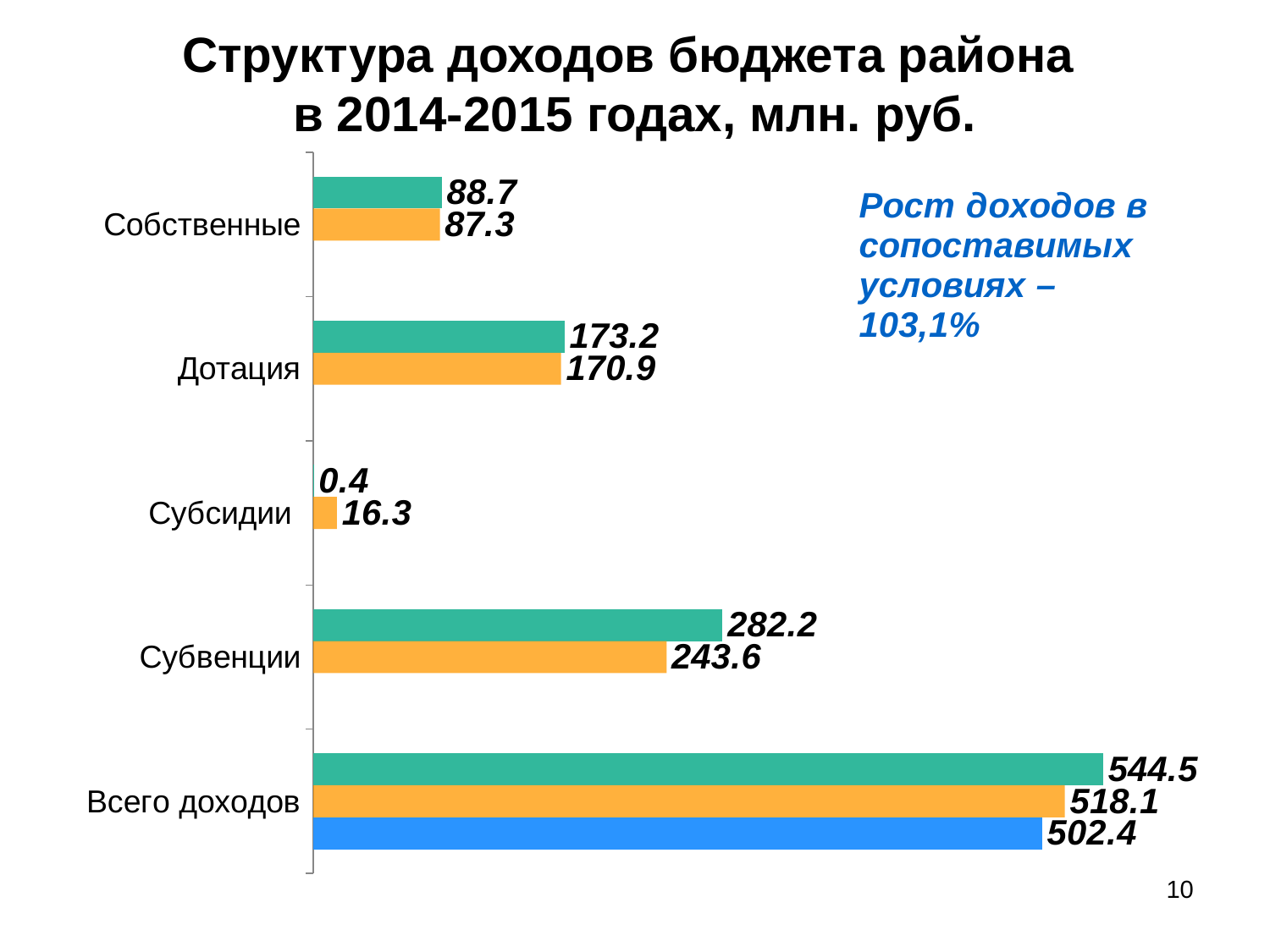
What is the value of the blue bar for Всего доходов? 502.4 What is the value of the orange bar for Дотация? 170.9 Which category has the highest green bar value? Всего доходов For Субсидии, which is larger: the green bar or the orange bar? the orange bar What is the value of the green bar for Собственные? 88.7 What is the value of the green bar for Субсидии? 0.4 Which category has the lowest orange bar value? Субсидии What growth of revenues in comparable conditions is stated in the text next to the chart? 103,1% What kind of chart is shown on the slide? bar chart How many categories are shown on the vertical axis of the chart? 5 What is the difference between the green and orange bar values for Всего доходов? 26.4 What is the difference between the green and orange bar values for Субвенции? 38.6